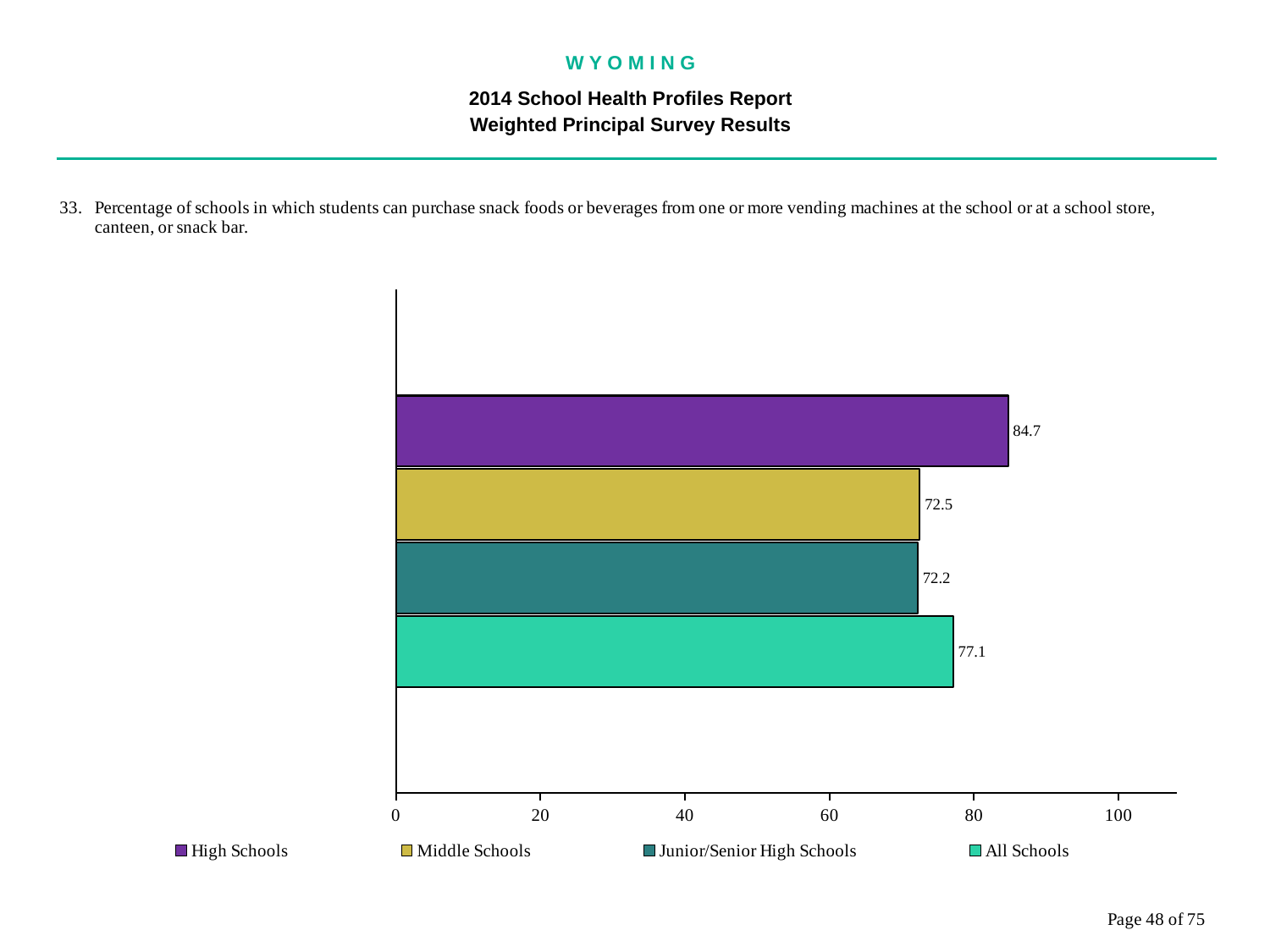
What kind of chart is shown on the slide? bar chart Which school category has the highest value? High Schools What is the value for All Schools? 77.1 What is the value for Middle Schools? 72.5 What is the value for Junior/Senior High Schools? 72.2 Which is larger, the value for High Schools or the value for All Schools? High Schools What is the value for High Schools? 84.7 Is the value for All Schools greater or less than 80? less How many bars are plotted on the chart? 4 What is the difference between the Middle Schools value and the Junior/Senior High Schools value? 0.3 What is the difference between the High Schools value and the All Schools value? 7.6 How many entries does the legend list? 4